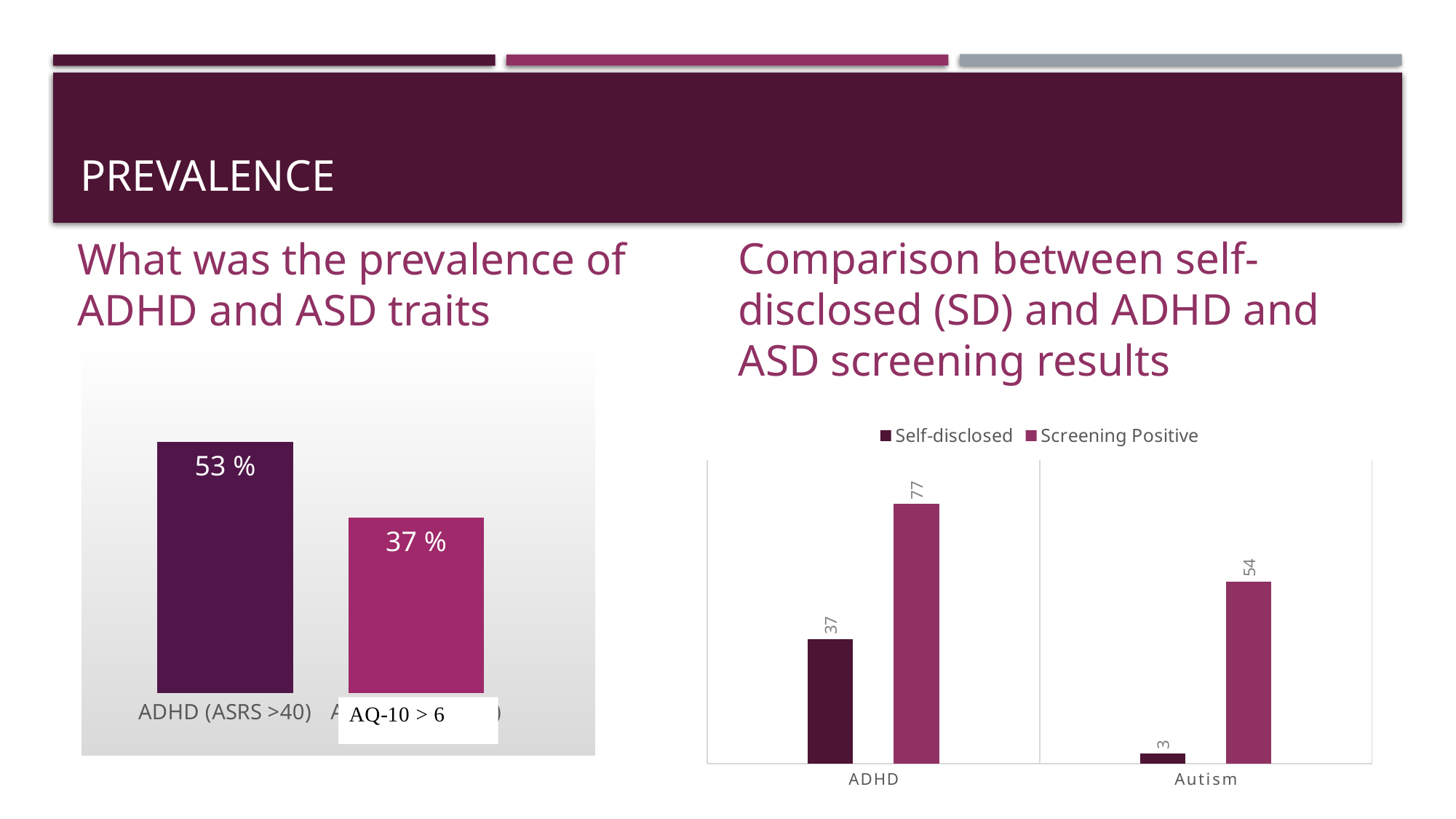
In the right chart (comparison between self-disclosed and screening results), how many series does the legend list? 2 In the right chart (comparison between self-disclosed and screening results), what is the difference between the Screening Positive and Self-disclosed values for ADHD? 40 In the right chart (comparison between self-disclosed and screening results), what is the Screening Positive value for Autism? 54 In the right chart (comparison between self-disclosed and screening results), what is the Self-disclosed value for ADHD? 37 In the left chart (prevalence of ADHD and ASD traits), what is the value shown on the second bar, labelled AQ-10 > 6? 37 % In the left chart (prevalence of ADHD and ASD traits), how many bars are plotted? 2 What kind of chart is the left chart (prevalence of ADHD and ASD traits)? Bar chart In the right chart (comparison between self-disclosed and screening results), what is the Self-disclosed value for Autism? 3 In the right chart (comparison between self-disclosed and screening results), which is larger: the Screening Positive value for ADHD or the Screening Positive value for Autism? Screening Positive for ADHD In the right chart (comparison between self-disclosed and screening results), which bar is the highest? Screening Positive for ADHD In the left chart (prevalence of ADHD and ASD traits), what is the value for ADHD (ASRS >40)? 53 % In the left chart (prevalence of ADHD and ASD traits), what is the difference between the ADHD (ASRS >40) bar and the AQ-10 > 6 bar? 16 %